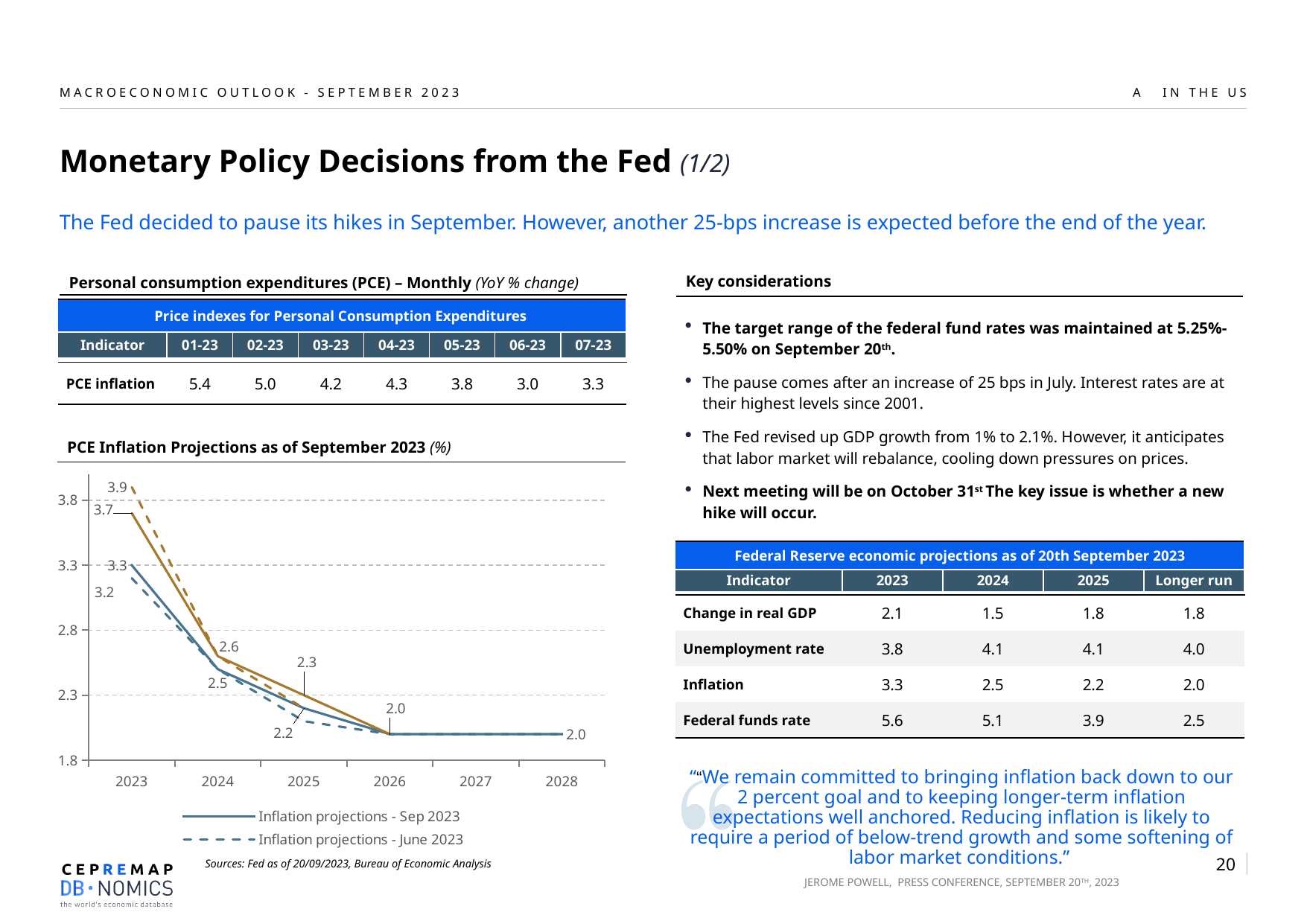
In the PCE Inflation Projections chart, are the values for 2027 greater or less than 2.3? less What are the two legend entries of the PCE Inflation Projections chart? Inflation projections - Sep 2023; Inflation projections - June 2023 In the PCE Inflation Projections chart, what value is labelled for 2026? 2.0 In the PCE Inflation Projections chart, what is the highest value labelled for 2023? 3.9 In the PCE Inflation Projections chart, what value is labelled for 2028? 2.0 In the PCE Inflation Projections chart, are the values for 2023 greater or less than 2.8? greater In the PCE Inflation Projections chart, do the projected values rise or fall from 2023 to 2026? fall How many years are shown on the x axis of the PCE Inflation Projections chart? 6 What kind of chart is the 'PCE Inflation Projections as of September 2023' chart? line chart In the PCE Inflation Projections chart, which year has higher projected values, 2023 or 2025? 2023 How many series does the legend of the PCE Inflation Projections chart list? 2 In the PCE Inflation Projections chart, what is the lowest value labelled for 2023? 3.2